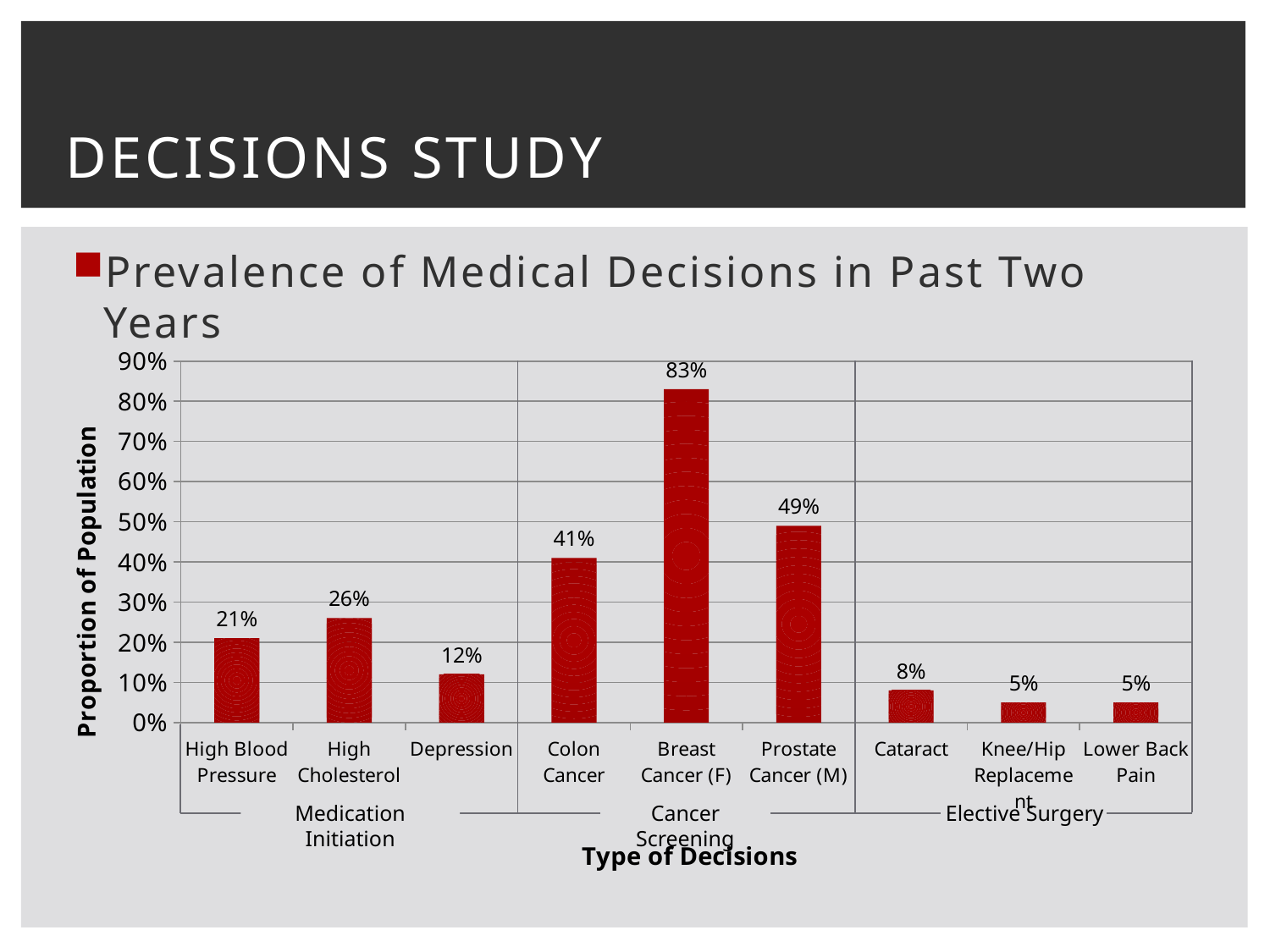
What is the difference between the values for Breast Cancer (F) and Prostate Cancer (M)? 34% Is the value for Colon Cancer greater or less than 30%? greater What is the value for High Cholesterol? 26% What is the value for Breast Cancer (F)? 83% Which category has the highest value? Breast Cancer (F) What is the difference between the values for Prostate Cancer (M) and Colon Cancer? 8% What is the value for Cataract? 8% How many categories are plotted on the chart? 9 Which group of decisions contains the Cataract, Knee/Hip Replacement and Lower Back Pain categories? Elective Surgery What kind of chart is shown on the slide? bar chart What is the label of the y axis? Proportion of Population Which is larger, the value for High Blood Pressure or the value for Depression? High Blood Pressure